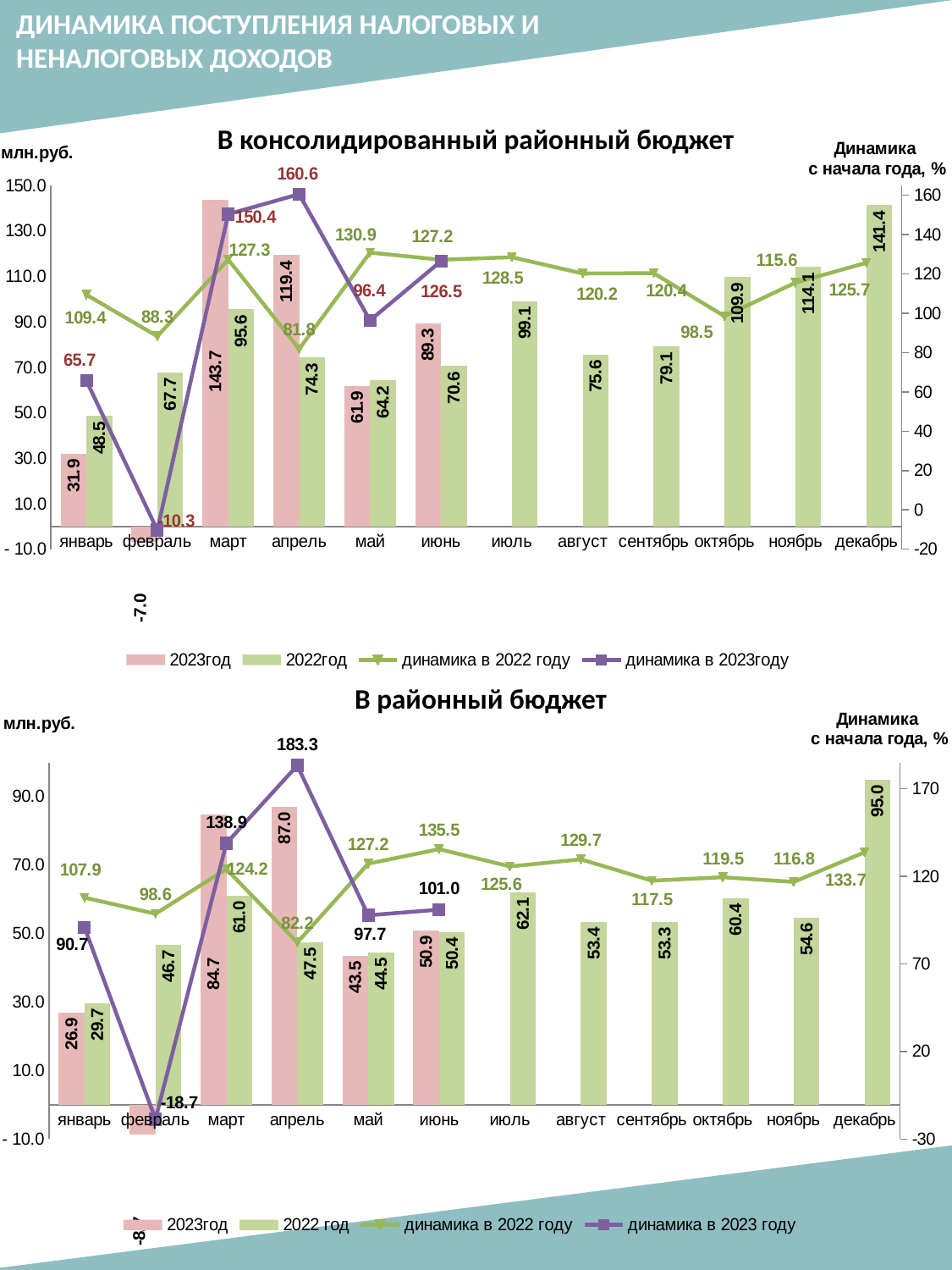
In the chart 'В районный бюджет', which is larger for май: the 2023год bar or the 2022 год bar? 2022 год In the chart 'В консолидированный районный бюджет', what is the value of 'динамика в 2023году' for апрель? 160.6 In the chart 'В районный бюджет', what is the highest value of 'динамика в 2023 году'? 183.3 In the chart 'В районный бюджет', what is the value of 'динамика в 2022 году' for июнь? 135.5 How many series does the legend of the chart 'В консолидированный районный бюджет' list? 4 What kind of chart is 'В районный бюджет'? Combined bar and line chart In the chart 'В консолидированный районный бюджет', what is the difference between the 2023год and 2022год bars for апрель? 45.1 In the chart 'В консолидированный районный бюджет', what is the value of the 2023год bar for март? 143.7 How many months are shown on the x axis of the chart 'В районный бюджет'? 12 In the chart 'В консолидированный районный бюджет', which month has the lowest value of 'динамика в 2022 году'? апрель In the chart 'В консолидированный районный бюджет', which month has the highest 2022год bar? декабрь In the chart 'В районный бюджет', what is the value of the 2022 год bar for декабрь? 95.0